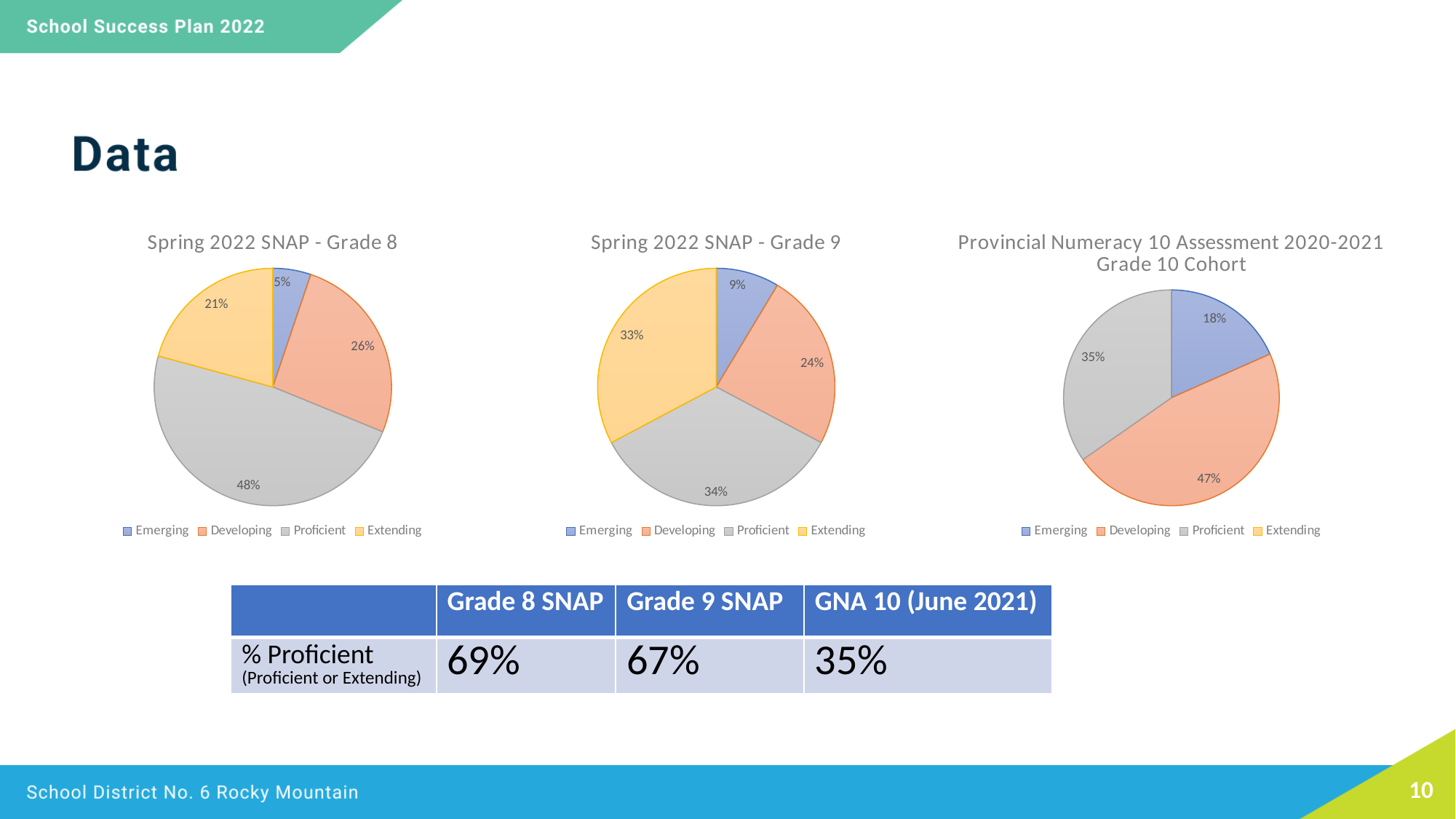
How many entries does the legend of the 'Spring 2022 SNAP - Grade 9' chart list? 4 What type of chart is 'Spring 2022 SNAP - Grade 8'? Pie chart In the 'Spring 2022 SNAP - Grade 8' chart, what percentage of students are Proficient? 48% In the 'Provincial Numeracy 10 Assessment 2020-2021 Grade 10 Cohort' chart, which category has the largest share? Developing How many pie charts are shown on the slide? 3 In the 'Spring 2022 SNAP - Grade 9' chart, what percentage of students are Extending? 33% In the 'Spring 2022 SNAP - Grade 8' chart, what percentage of students are Emerging? 5% In the 'Spring 2022 SNAP - Grade 8' chart, which category has the largest share? Proficient In the 'Spring 2022 SNAP - Grade 8' chart, what is the difference between the Proficient and Developing shares? 22% In the 'Spring 2022 SNAP - Grade 9' chart, which category has the smallest share? Emerging In the 'Spring 2022 SNAP - Grade 9' chart, which is larger, the Developing share or the Extending share? Extending In the 'Provincial Numeracy 10 Assessment 2020-2021 Grade 10 Cohort' chart, what percentage of students are Developing? 47%